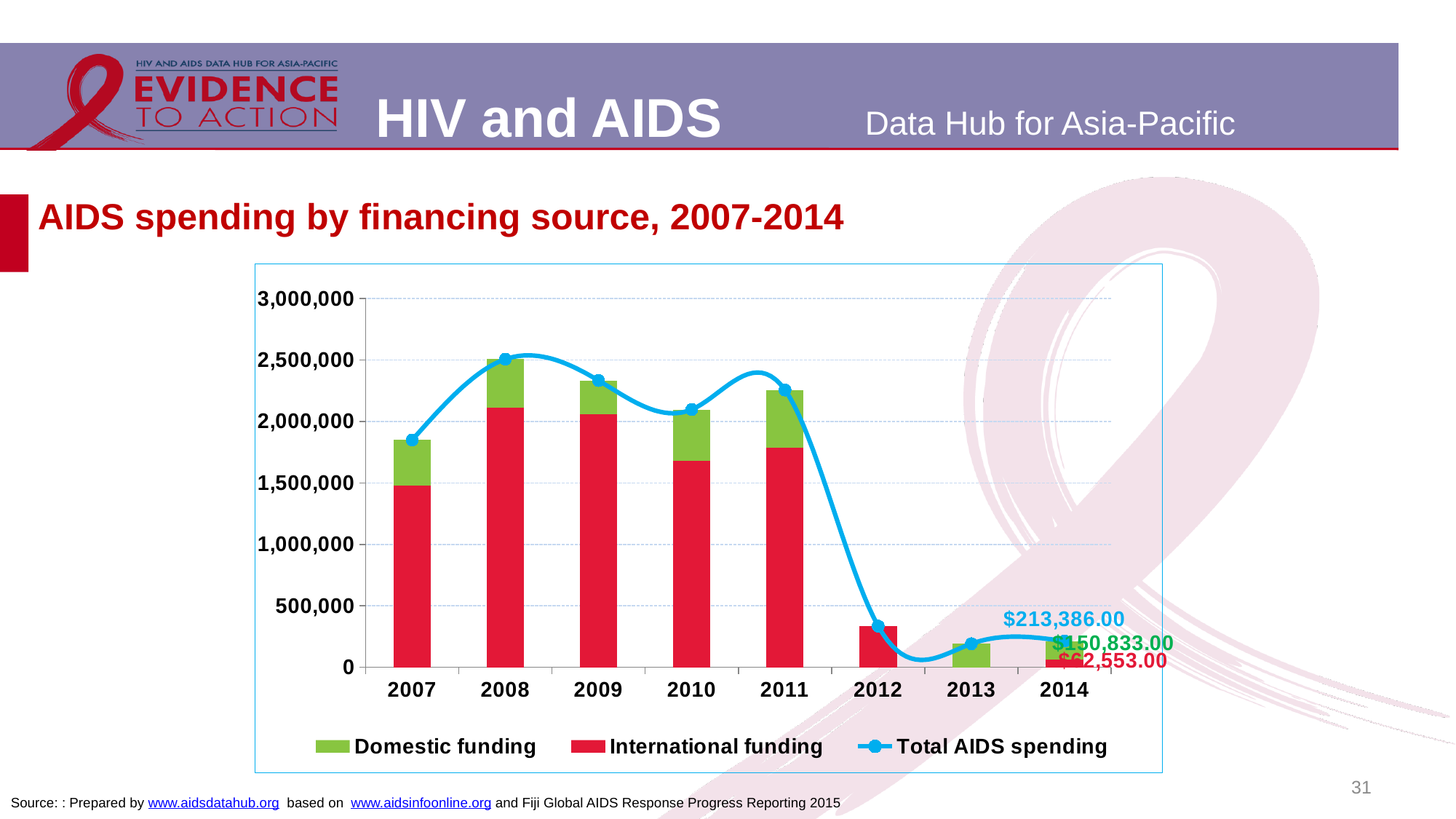
Is the Total AIDS spending for 2007 greater or less than 2,000,000? less Which is larger in 2014, Domestic funding or International funding? Domestic funding What is the difference between Domestic funding and International funding in 2014? $88,280.00 How many years are shown on the x axis? 8 What is the International funding value labelled for 2014? $62,553.00 What kind of chart is shown? Bar chart with a line What is the Total AIDS spending value labelled for 2014? $213,386.00 Is the International funding for 2011 greater or less than 1,500,000? greater How many series does the legend list? 3 In which year was Total AIDS spending highest? 2008 What is the Domestic funding value labelled for 2014? $150,833.00 Is the Total AIDS spending for 2012 greater or less than 500,000? less